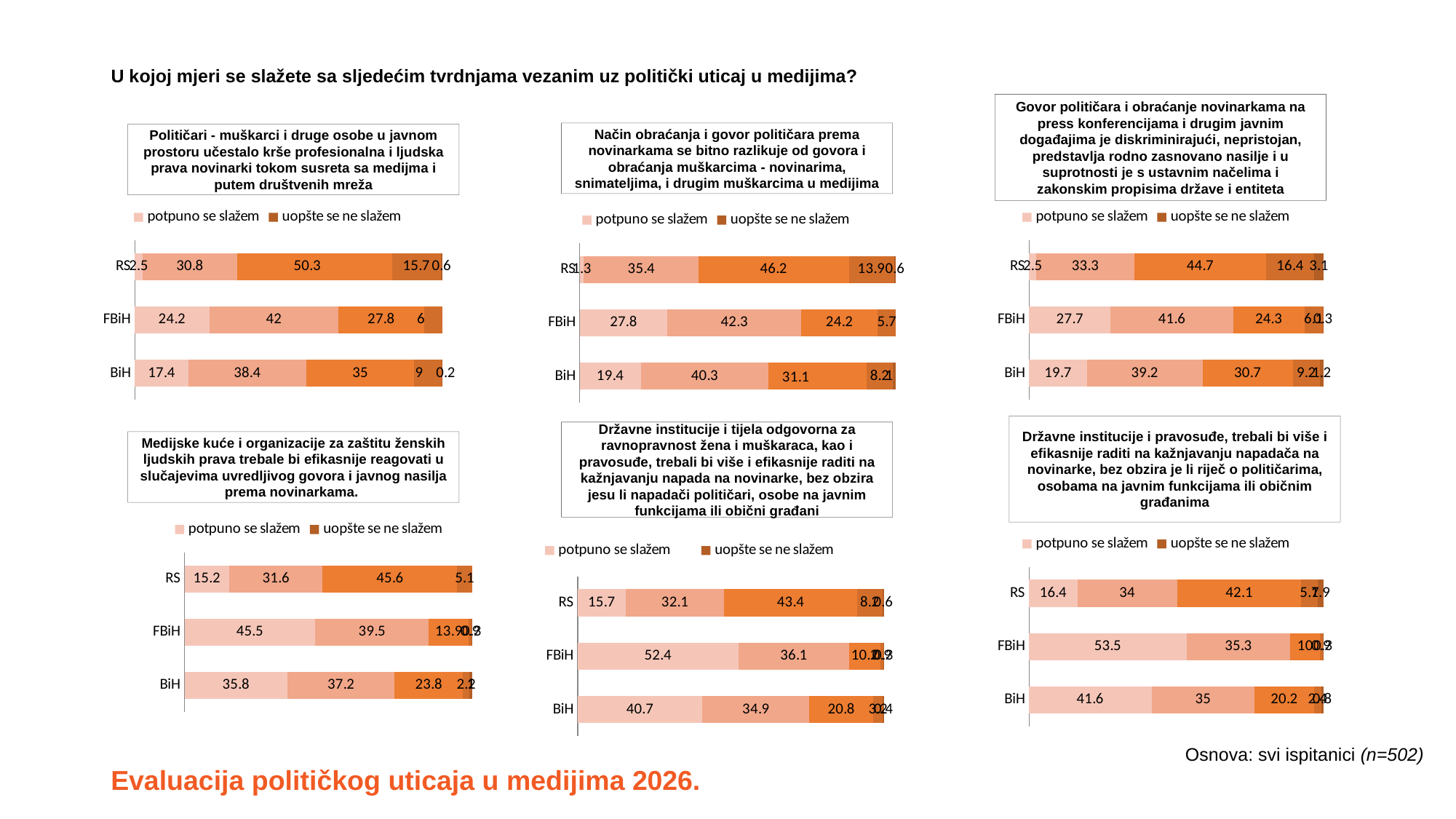
In the chart titled 'Način obraćanja i govor političara prema novinarkama...', is the 'potpuno se slažem' value larger for FBiH or for BiH? FBiH In the chart titled 'Medijske kuće i organizacije za zaštitu ženskih ljudskih prava...', which category has the lowest 'potpuno se slažem' value? RS How many series does the legend list in the chart titled 'Medijske kuće i organizacije za zaštitu ženskih ljudskih prava...'? 2 In the chart titled 'Način obraćanja i govor političara prema novinarkama...', what is the 'potpuno se slažem' value for BiH? 19.4 In the chart titled 'Govor političara i obraćanje novinarkama na press konferencijama...', what is the 'uopšte se ne slažem' value for RS? 3.1 In the chart titled 'Državne institucije i tijela odgovorna za ravnopravnost žena i muškaraca...', what is the 'potpuno se slažem' value for BiH? 40.7 In the chart titled 'Medijske kuće i organizacije za zaštitu ženskih ljudskih prava...', what is the 'potpuno se slažem' value for FBiH? 45.5 In the chart titled 'Državne institucije i pravosuđe, trebali bi više i efikasnije raditi...', which category has the highest 'potpuno se slažem' value? FBiH In the chart titled 'Državne institucije i pravosuđe, trebali bi više i efikasnije raditi...', what is the difference between the 'potpuno se slažem' values for FBiH and RS? 37.1 In the chart titled 'Političari - muškarci i druge osobe u javnom prostoru...', what is the 'potpuno se slažem' value for FBiH? 24.2 How many categories are shown on the y axis of the chart titled 'Političari - muškarci i druge osobe u javnom prostoru...'? 3